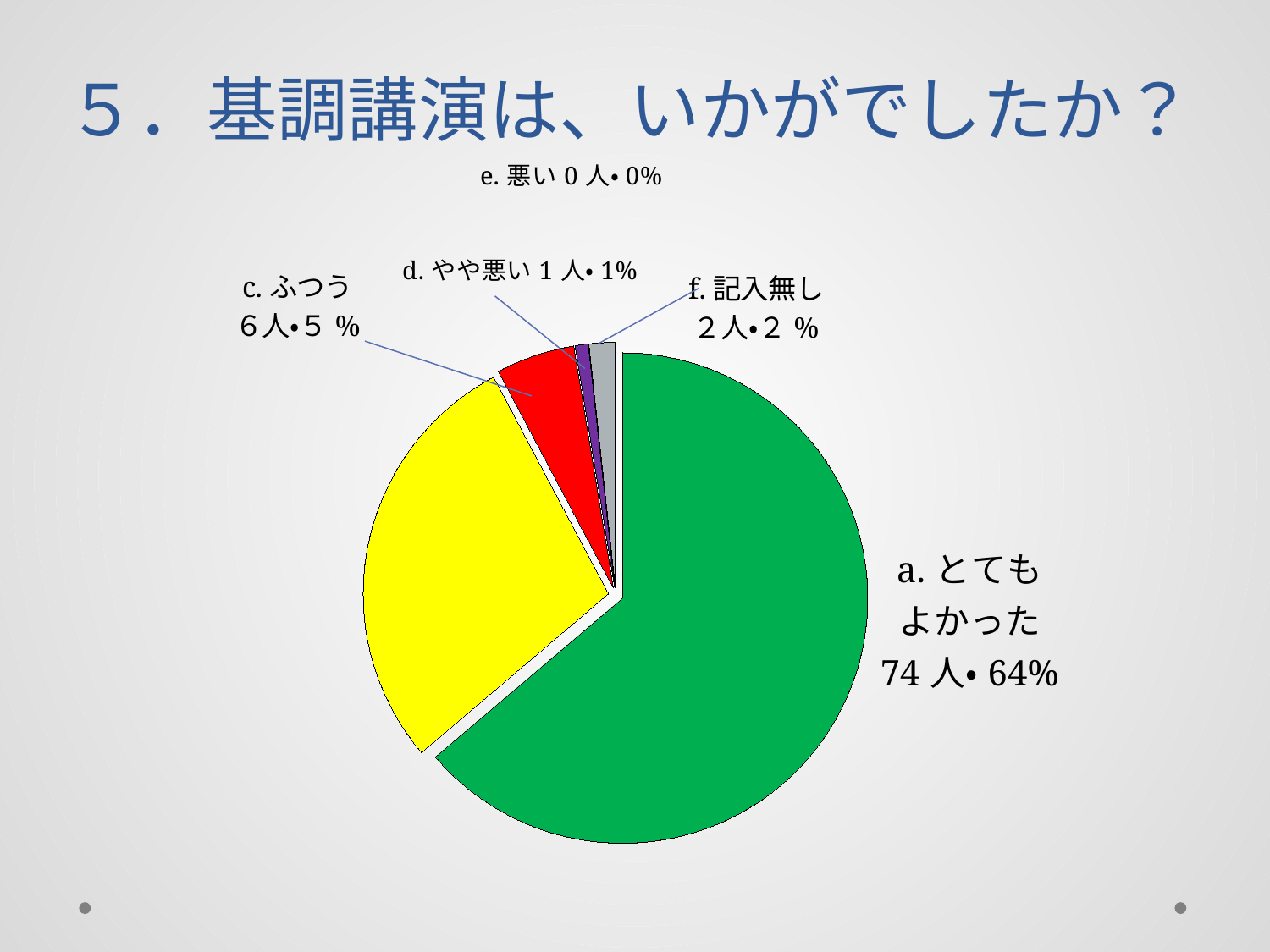
What percentage of the pie does a. とてもよかった represent? 64% How many people chose e. 悪い? 0 人 How many people chose c. ふつう? 6人 Which has more people, c. ふつう or f. 記入無し? c. ふつう What percentage is shown for c. ふつう? 5 % How many people chose d. やや悪い? 1 人 How many people chose a. とてもよかった? 74 人 What colour is the slice for a. とてもよかった? green What kind of chart is shown on the slide? pie chart How many more people chose a. とてもよかった than c. ふつう? 68 人 Which labelled category has the largest slice of the pie? a. とてもよかった What percentage is shown for f. 記入無し? 2 %